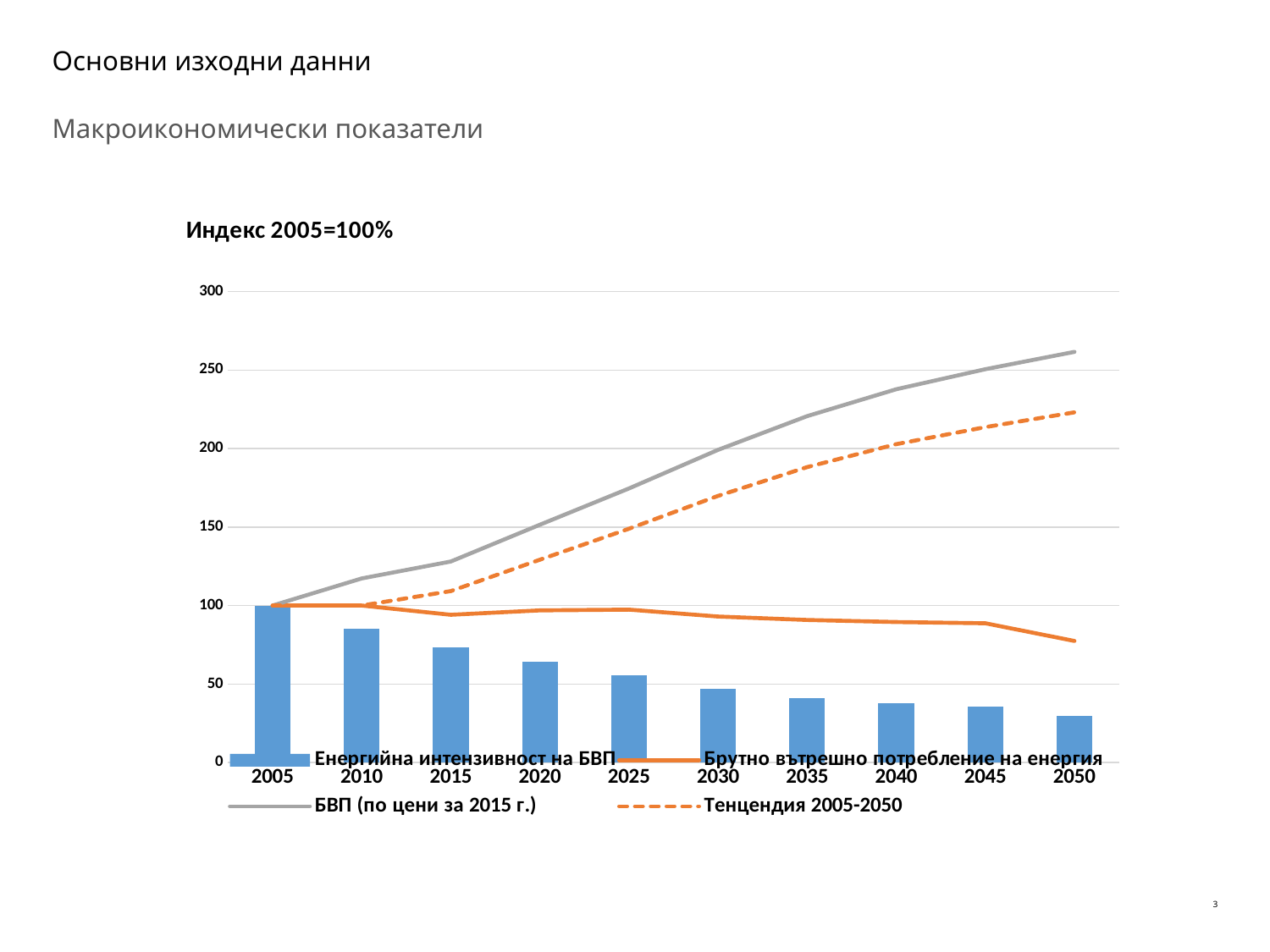
What kind of chart is shown on the slide? A combined bar and line chart Is the Енергийна интензивност на БВП value for 2050 greater or less than 50? less How many years are shown on the x axis of the chart? 10 What is the value of the Енергийна интензивност на БВП bar for 2005? 100 How many series does the chart legend list? 4 In 2050, which is larger: БВП (по цени за 2015 г.) or Тенцендия 2005-2050? БВП (по цени за 2015 г.) In which year is the Енергийна интензивност на БВП bar the lowest? 2050 Is the Енергийна интензивност на БВП value for 2010 greater or less than 50? greater Is the Брутно вътрешно потребление на енергия value for 2050 greater or less than 100? less Do the Енергийна интензивност на БВП bars rise or fall from 2005 to 2050? fall In which year is the Енергийна интензивност на БВП bar the highest? 2005